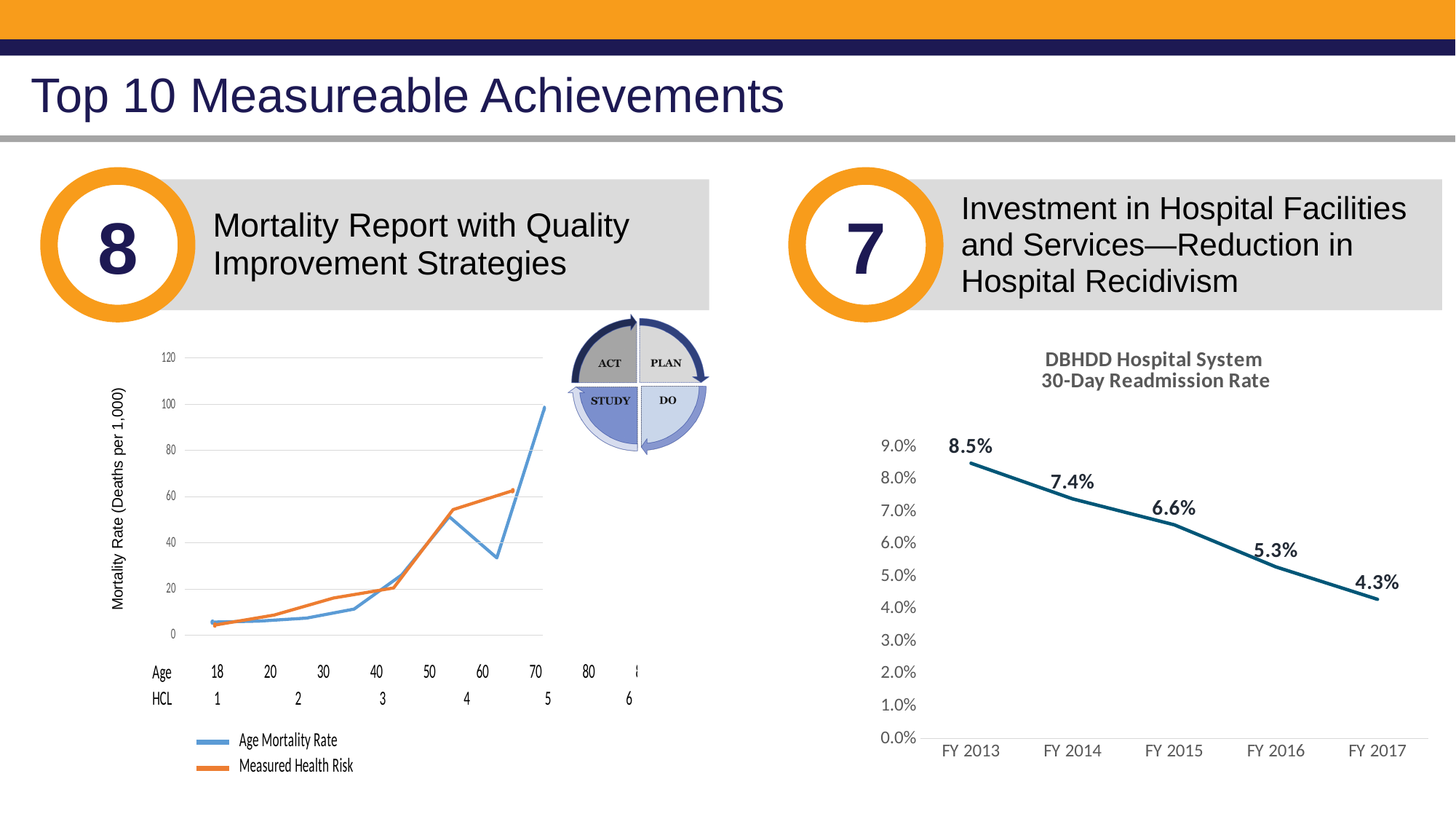
In the DBHDD Hospital System 30-Day Readmission Rate chart, what is the readmission rate for FY 2015? 6.6% What kind of chart is the mortality chart on the left side of the slide? line chart In the DBHDD Hospital System 30-Day Readmission Rate chart, which fiscal year has the lowest readmission rate? FY 2017 In the DBHDD Hospital System 30-Day Readmission Rate chart, which fiscal year has the highest readmission rate? FY 2013 How many series does the legend of the mortality chart on the left list? 2 In the DBHDD Hospital System 30-Day Readmission Rate chart, how many fiscal years are plotted? 5 In the DBHDD Hospital System 30-Day Readmission Rate chart, what is the readmission rate for FY 2017? 4.3% What is the y-axis label of the mortality chart on the left? Mortality Rate (Deaths per 1,000) In the DBHDD Hospital System 30-Day Readmission Rate chart, by how many percentage points did the rate fall from FY 2013 to FY 2017? 4.2 percentage points In the mortality chart on the left, is the highest value of the Age Mortality Rate line greater or less than 80? greater In the DBHDD Hospital System 30-Day Readmission Rate chart, which is larger: the rate for FY 2014 or the rate for FY 2016? FY 2014 In the DBHDD Hospital System 30-Day Readmission Rate chart, do the values rise or fall from FY 2013 to FY 2017? fall